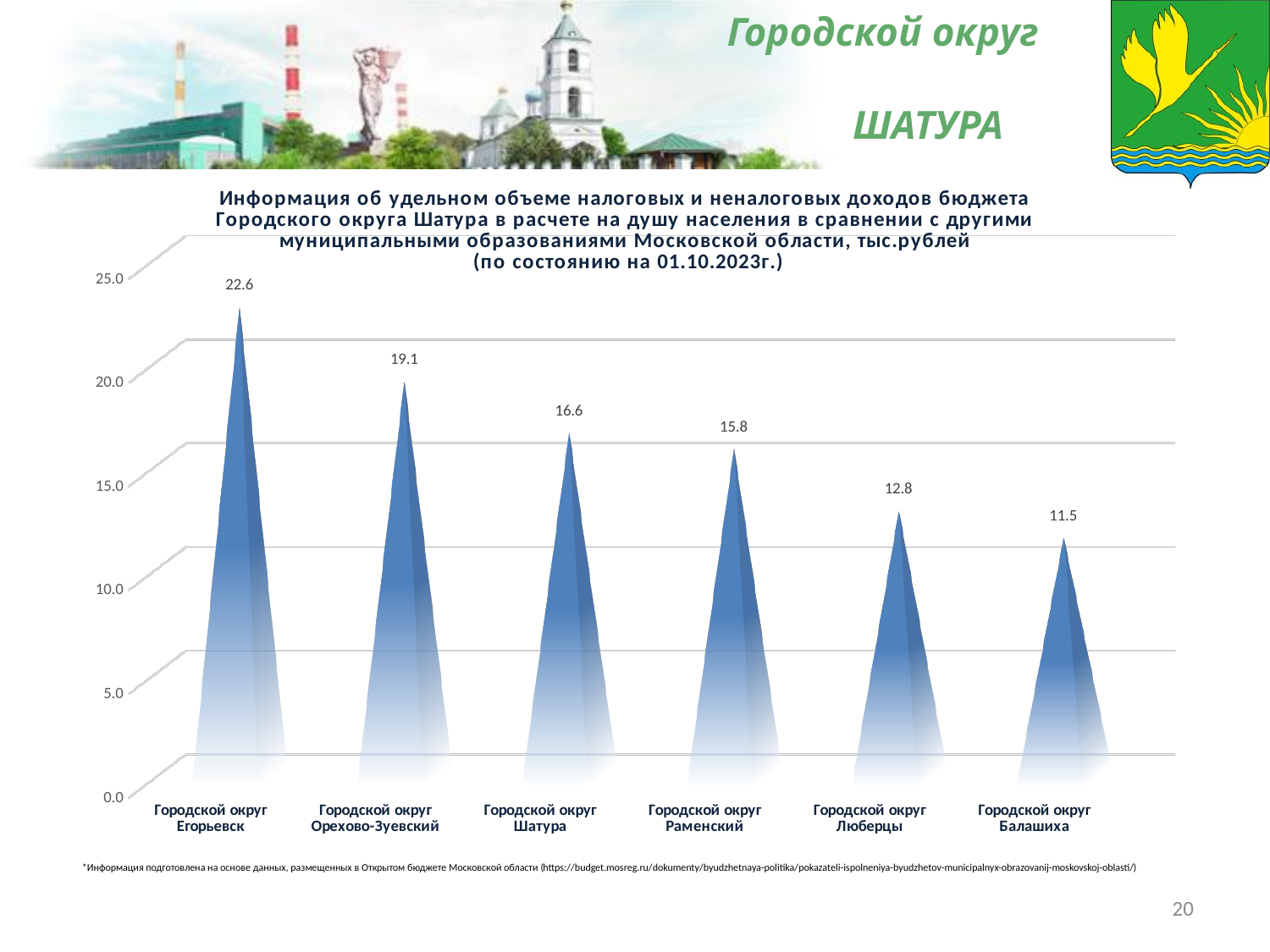
What kind of chart is shown on the slide? Bar chart Which municipality has the highest value? Городской округ Егорьевск What is the difference between the values for Городской округ Егорьевск and Городской округ Шатура? 6.0 What is the value for Городской округ Шатура? 16.6 Which is larger, the value for Городской округ Шатура or Городской округ Раменский? Городской округ Шатура What is the difference between the values for Городской округ Орехово-Зуевский and Городской округ Раменский? 3.3 What is the value for Городской округ Егорьевск? 22.6 What is the value for Городской округ Люберцы? 12.8 What is the value for Городской округ Балашиха? 11.5 Do the values rise or fall from left to right across the chart? Fall How many municipalities are shown on the chart? 6 Which municipality has the lowest value? Городской округ Балашиха